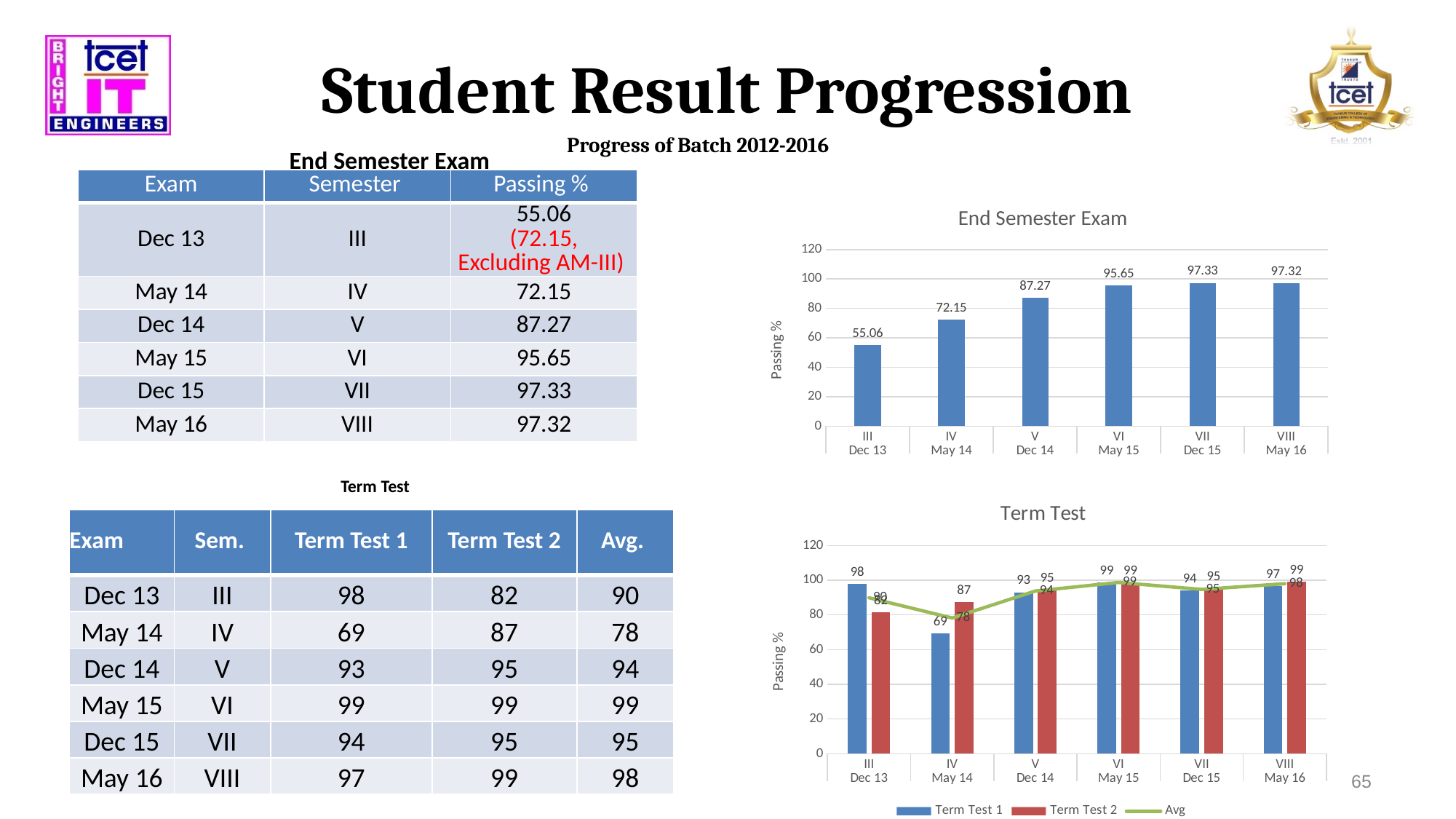
In the Term Test chart, what is the difference between Term Test 1 and Term Test 2 for semester III (Dec 13)? 16 In the End Semester Exam chart, what is the difference between the passing % for semester IV (May 14) and semester III (Dec 13)? 17.09 In the End Semester Exam chart, which semester has the lowest passing %? III (Dec 13) What kind of chart is the End Semester Exam chart? Bar chart How many series does the legend of the Term Test chart list? 3 In the Term Test chart, what is the Term Test 2 value for semester VIII (May 16)? 99 How many semesters are plotted in the End Semester Exam chart? 6 In the Term Test chart, what is the Term Test 1 value for semester IV (May 14)? 69 In the End Semester Exam chart, do the values rise or fall from semester III to semester VI? Rise In the Term Test chart, which is larger for semester IV (May 14): Term Test 1 or Term Test 2? Term Test 2 In the Term Test chart, which semester has the lowest Term Test 1 value? IV (May 14) In the End Semester Exam chart, what is the passing % for semester V (Dec 14)? 87.27